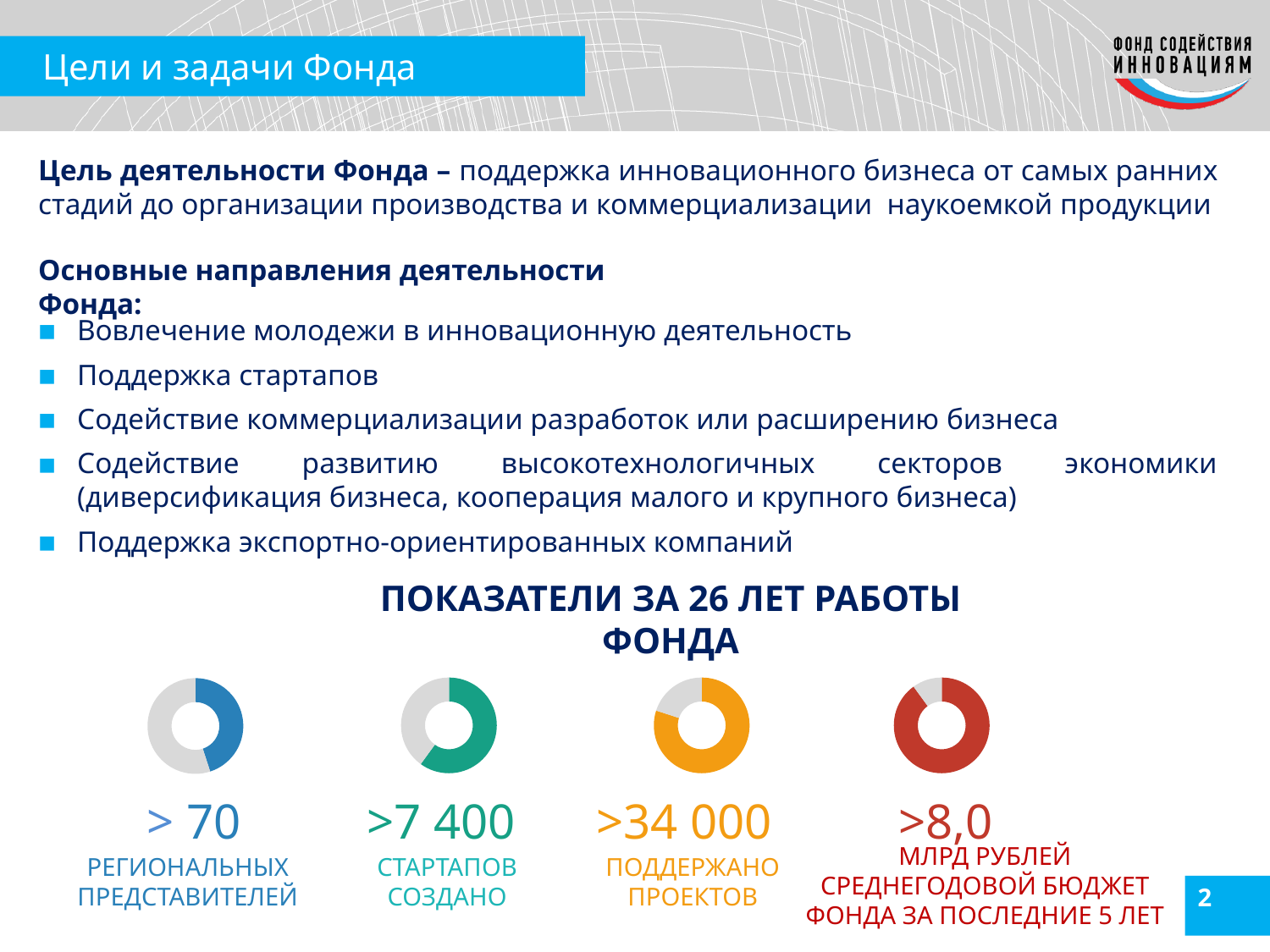
Which printed figure is larger: the one for startups created or the one for supported projects? Supported projects (>34 000) What kind of charts are shown under the heading "ПОКАЗАТЕЛИ ЗА 26 ЛЕТ РАБОТЫ ФОНДА"? Donut (pie) charts What figure is printed under the third (orange) donut chart for supported projects (ПОДДЕРЖАНО ПРОЕКТОВ)? >34 000 Over how many years does the heading say the indicators were accumulated? 26 лет What is the heading above the four donut charts? ПОКАЗАТЕЛИ ЗА 26 ЛЕТ РАБОТЫ ФОНДА What figure is printed under the second (green) donut chart for startups created (СТАРТАПОВ СОЗДАНО)? >7 400 Which indicator has the smallest printed number among the four donut charts? МЛРД РУБЛЕЙ СРЕДНЕГОДОВОЙ БЮДЖЕТ ФОНДА (>8,0) How many donut charts are shown on the slide? 4 What colour is the donut chart for supported projects (ПОДДЕРЖАНО ПРОЕКТОВ)? Orange Which indicator has the largest printed number among the four donut charts? ПОДДЕРЖАНО ПРОЕКТОВ (>34 000) What figure is printed under the fourth (red) donut chart for the average annual budget of the Fund over the last 5 years? >8,0 млрд рублей What figure is printed under the first (blue) donut chart for regional representatives (РЕГИОНАЛЬНЫХ ПРЕДСТАВИТЕЛЕЙ)? > 70